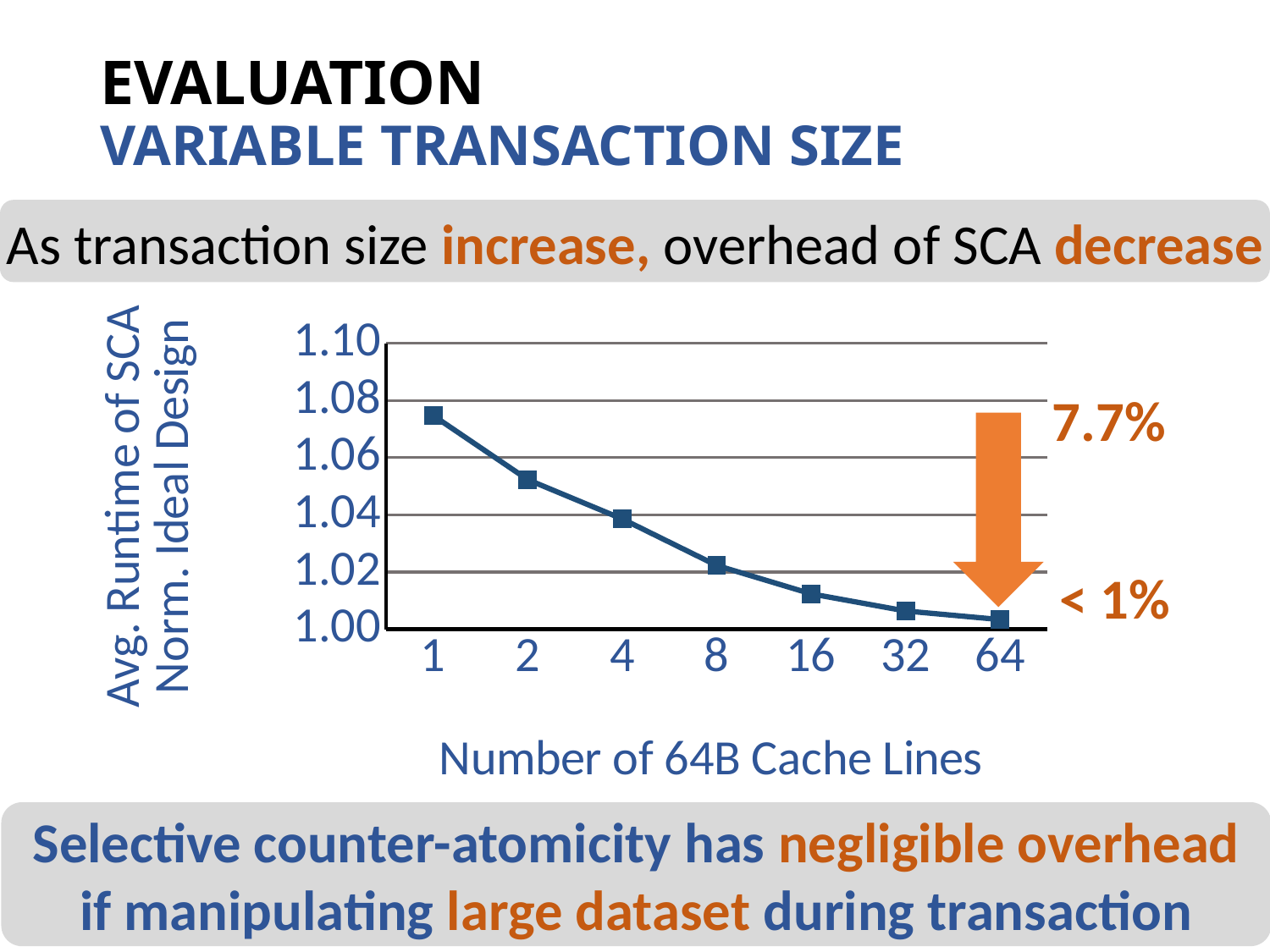
What is the title of the x axis? Number of 64B Cache Lines Do the values rise or fall as the number of 64B cache lines increases along the x axis? fall What overhead percentage is annotated next to the top of the orange arrow? 7.7% How many data points are plotted on the chart? 7 Is the value for 16 cache lines greater or less than 1.02? less What kind of chart is shown on the slide? line chart Which number of 64B cache lines has the highest average runtime of SCA? 1 Which number of 64B cache lines has the lowest average runtime of SCA? 64 Which has a larger average runtime of SCA: 1 cache line or 64 cache lines? 1 cache line Is the value for 64 cache lines greater or less than 1.02? less Is the value for 2 cache lines greater or less than 1.04? greater